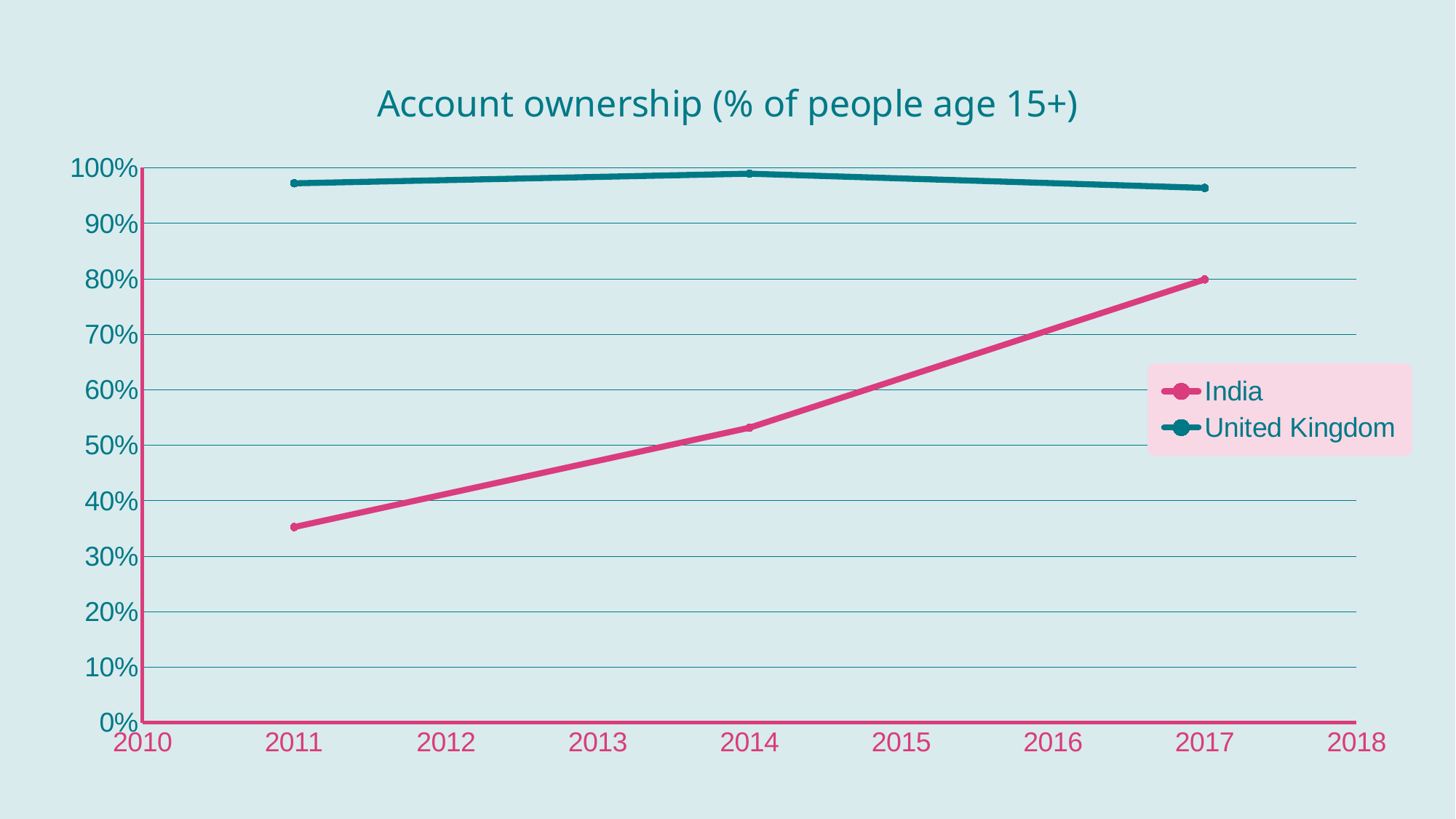
How many series does the legend list? 2 In which year is the value for India highest? 2017 Is the value for India in 2017 greater or less than 70%? greater Is the value for the United Kingdom in 2011 greater or less than 90%? greater Is the value for India in 2014 greater or less than 50%? greater Which two series are shown in the legend? India and United Kingdom Do the values for India rise or fall from 2011 to 2017? rise Which series has the larger value in 2014, India or the United Kingdom? United Kingdom How many data points are plotted for the India series? 3 What is the title of the chart? Account ownership (% of people age 15+) What kind of chart is shown on the slide? line chart